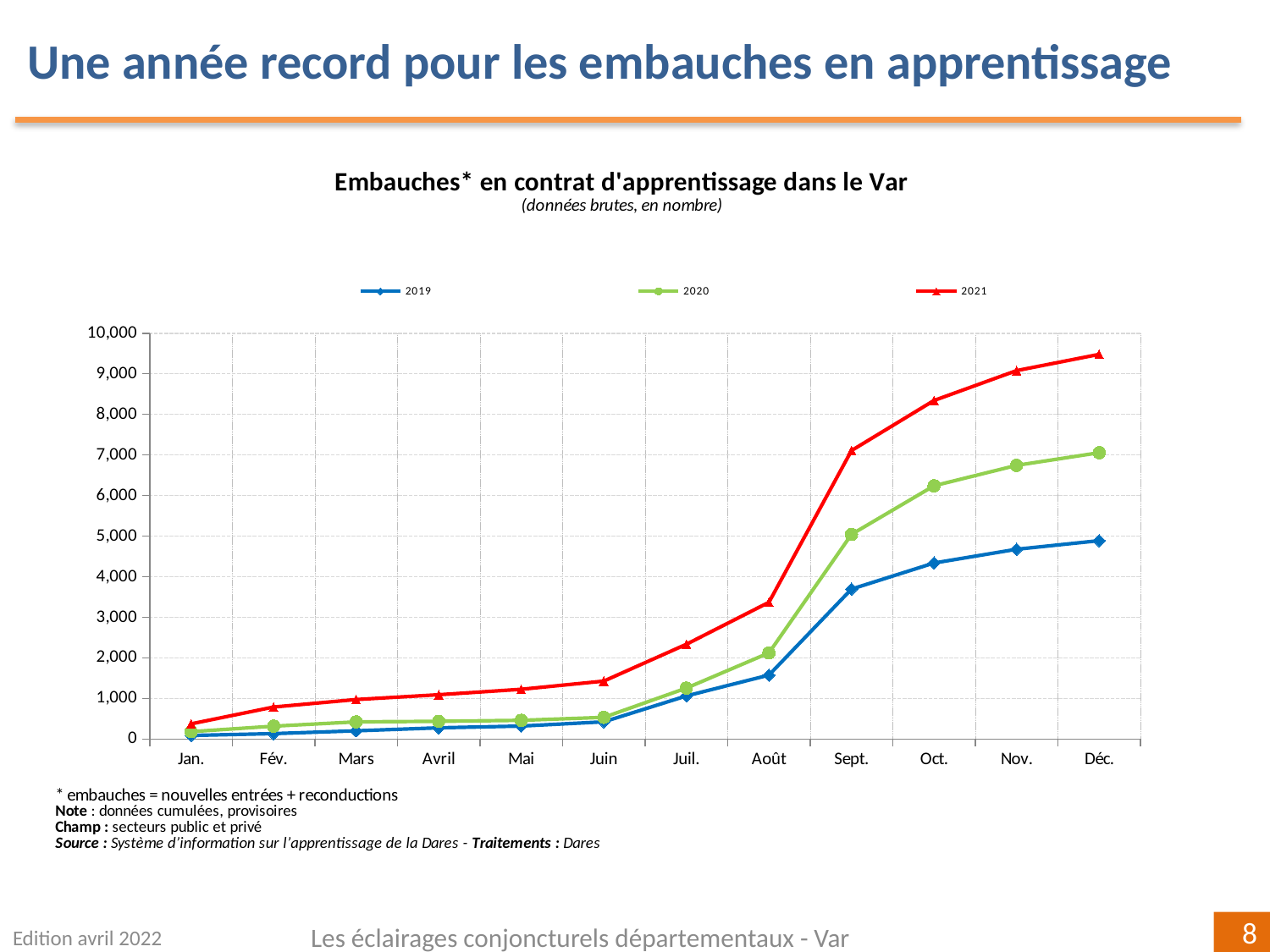
Which series has the lowest value in Déc.? 2019 Do the values for 2021 rise or fall from Jan. to Déc.? rise In Sept., which series has the larger value, 2020 or 2021? 2021 What is the title of the chart? Embauches* en contrat d'apprentissage dans le Var How many months are shown along the x axis? 12 How many series does the legend list? 3 What kind of chart is shown on the slide? line chart Which years are listed in the legend? 2019, 2020, 2021 Is the value for 2020 in Déc. greater or less than 8,000? less Is the value for 2021 in Sept. greater or less than 6,000? greater Is the value for 2021 in Déc. greater or less than 9,000? greater